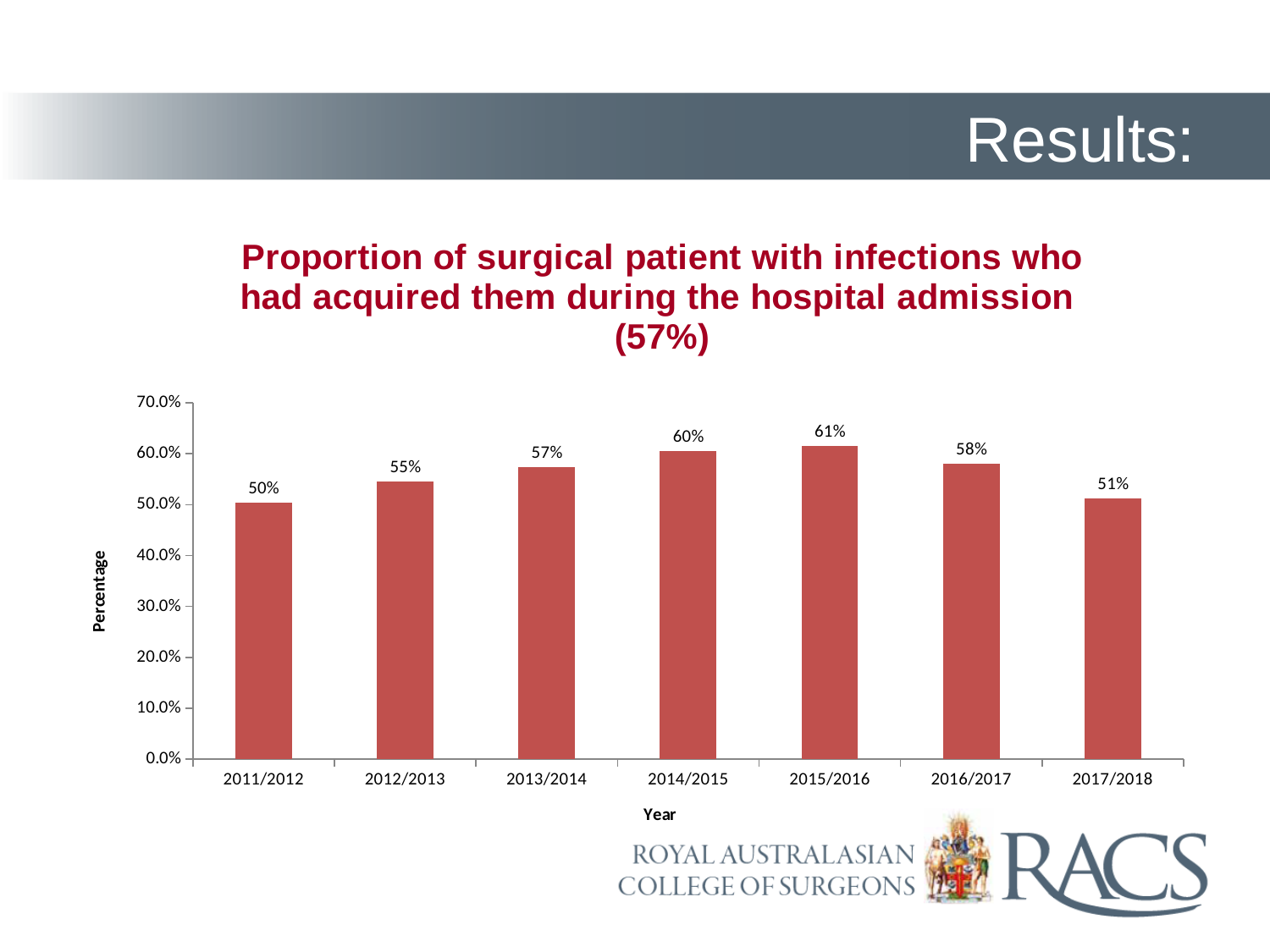
Which is larger, the value for 2014/2015 or the value for 2016/2017? 2014/2015 Is the value for 2013/2014 greater or less than 50.0%? greater What is the value for 2011/2012? 50% Which year has the highest value? 2015/2016 How many years are shown on the x axis? 7 Do the values rise or fall from 2011/2012 to 2015/2016? rise What is the value for 2015/2016? 61% What is the value for 2017/2018? 51% Which year has the lowest value? 2011/2012 What is the label of the y axis? Percentage What is the difference between the values for 2015/2016 and 2011/2012? 11% What kind of chart is shown on the slide? bar chart